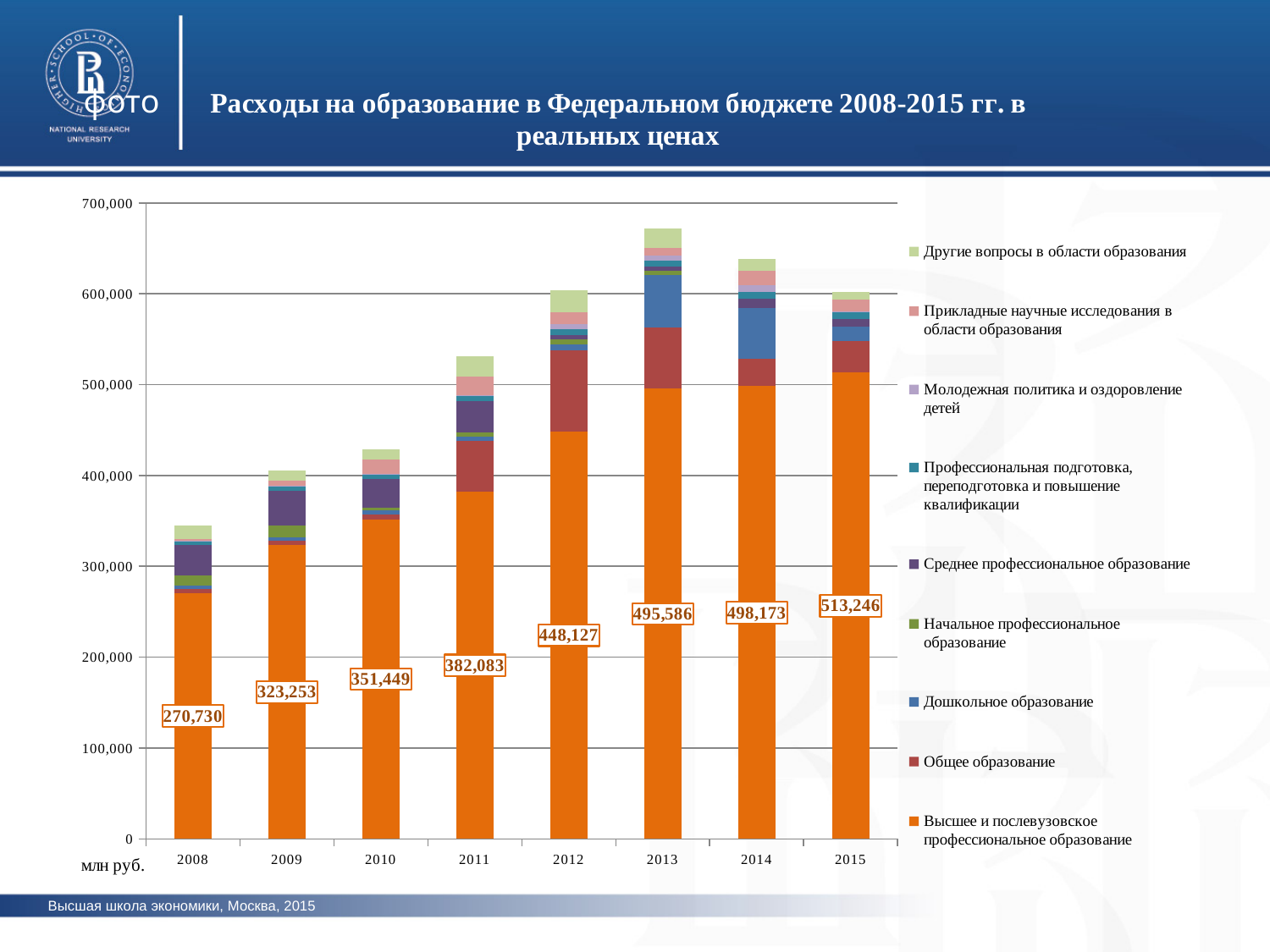
How many series does the legend list? 9 What is the value of the Высшее и послевузовское профессиональное образование series for 2012? 448,127 How many years are shown on the x axis? 8 In which year is the labelled Высшее и послевузовское профессиональное образование value the highest? 2015 What is the difference between the Высшее и послевузовское профессиональное образование values for 2015 and 2014? 15,073 What kind of chart is shown on the slide? Stacked bar chart Is the total height of the stacked bar for 2008 greater or less than 400,000? less Is the total height of the stacked bar for 2013 greater or less than 600,000? greater What is the value of the Высшее и послевузовское профессиональное образование series for 2015? 513,246 Which year has the larger Высшее и послевузовское профессиональное образование value, 2010 or 2011? 2011 In which year is the labelled Высшее и послевузовское профессиональное образование value the lowest? 2008 What is the value of the Высшее и послевузовское профессиональное образование series for 2008? 270,730